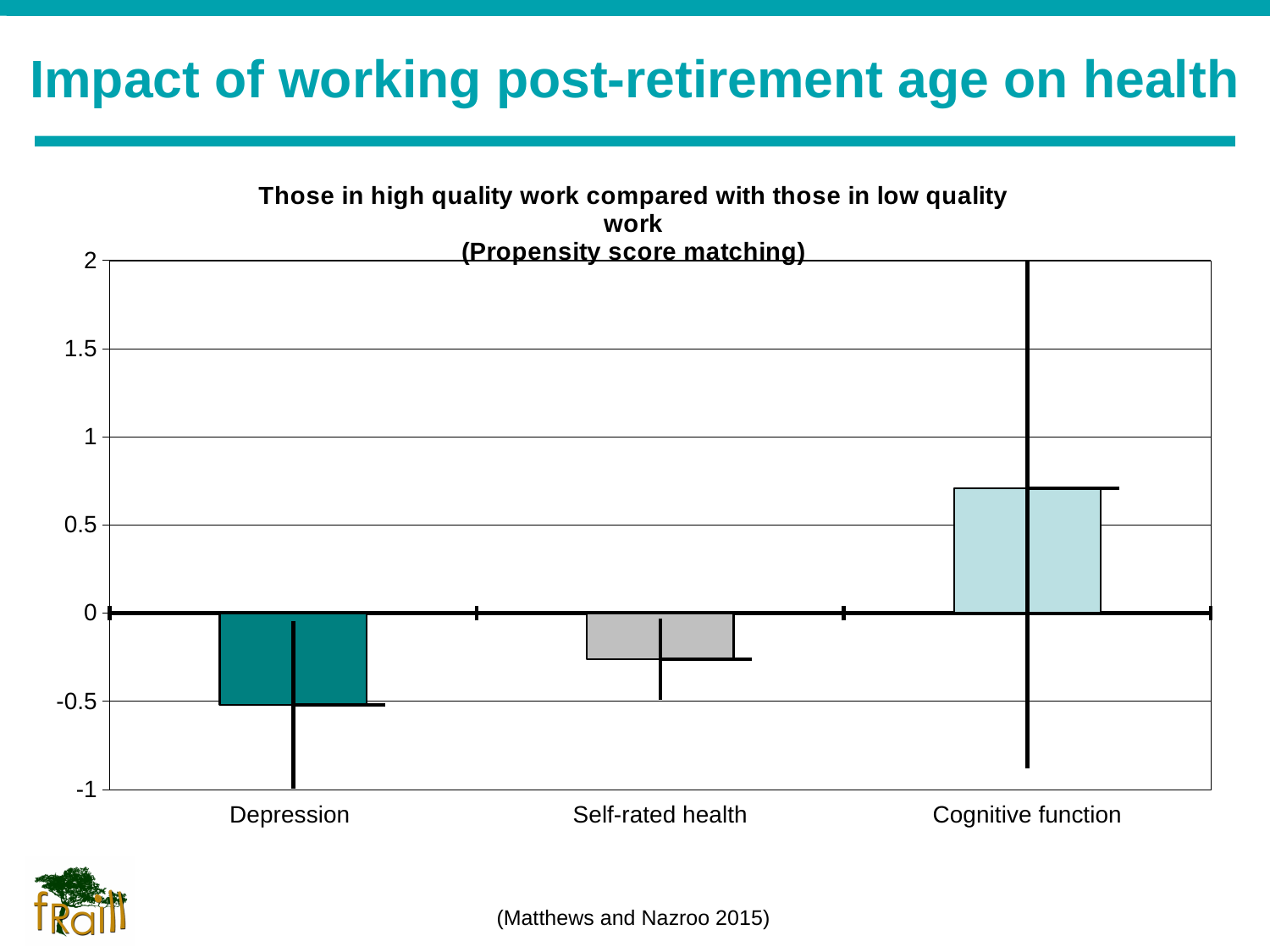
Is the value for Depression greater or less than 0? less What matching method is named in the chart title? Propensity score matching Do the bar values rise or fall moving from Depression to Cognitive function along the x axis? rise How many categories are shown on the x axis of the chart? 3 Which is larger, the value for Self-rated health or the value for Cognitive function? Cognitive function Which is larger, the value for Depression or the value for Self-rated health? Self-rated health Is the value for Self-rated health greater or less than -0.5? greater Is the value for Cognitive function greater or less than 0.5? greater Which category has the lowest value in the chart? Depression What kind of chart is shown on the slide? bar chart Which category has the highest value in the chart? Cognitive function